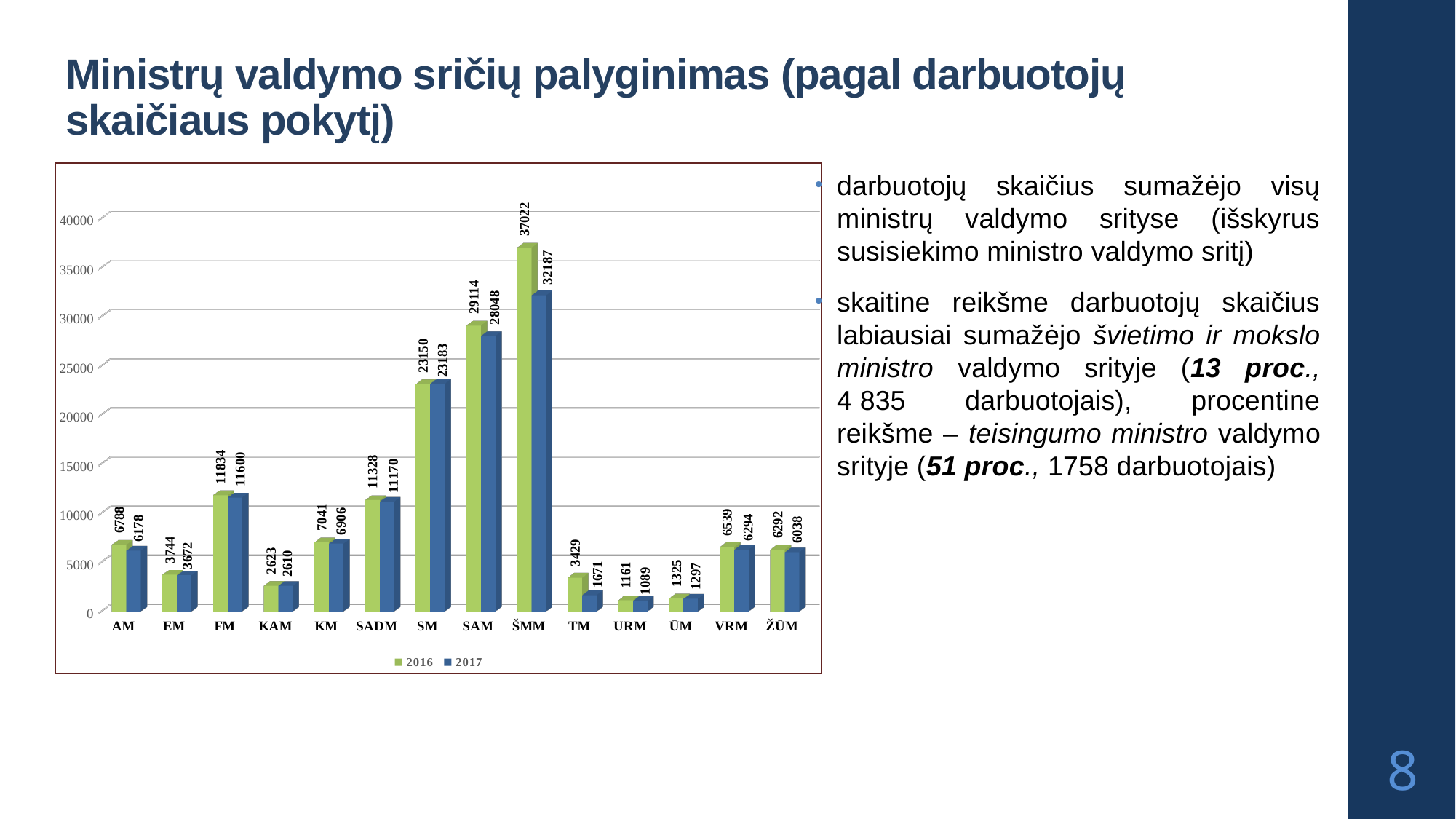
Which category has the lowest 2016 value? URM Is the 2016 value for SAM greater or less than 25000? greater How many categories are shown on the x axis? 14 What is the difference between the 2016 and 2017 values for ŠMM? 4835 Which category has the highest 2017 value? ŠMM Which is larger for SM, the 2016 value or the 2017 value? 2017 What is the 2017 value for TM? 1671 What kind of chart is shown on the slide? bar chart What is the difference between the 2016 and 2017 values for TM? 1758 How many series does the legend list? 2 What is the 2016 value for ŠMM? 37022 What is the 2016 value for SADM? 11328